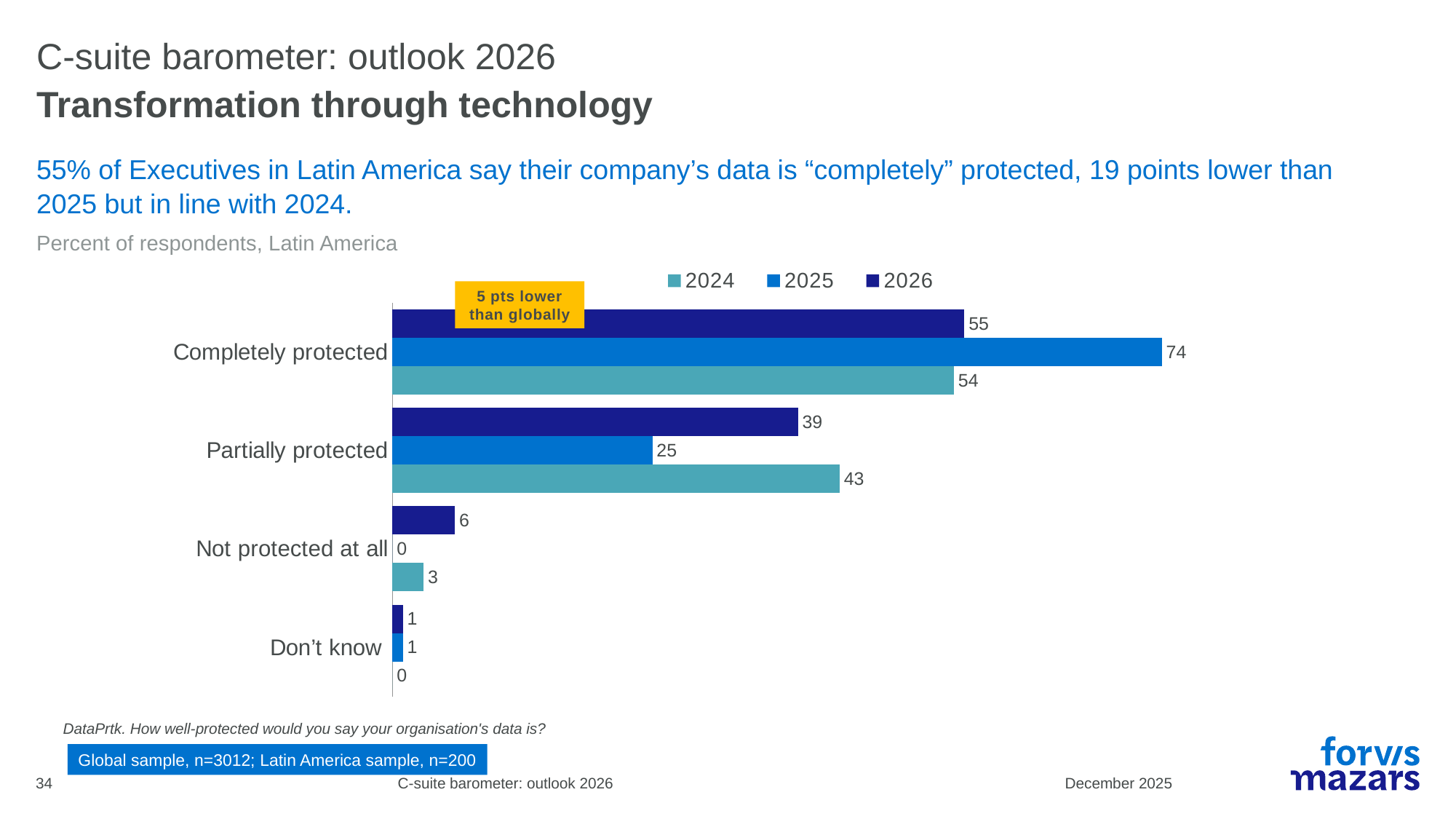
What is the 2024 value for Not protected at all? 3 Which category has the highest 2025 value? Completely protected What is the difference between the 2025 and 2026 values for Completely protected? 19 What is the 2026 value for Not protected at all? 6 What is the 2026 value for Completely protected? 55 What does the yellow callout box on the chart say? 5 pts lower than globally How many categories are shown on the chart? 4 Which category has the lowest 2024 value? Don't know How many series does the legend list? 3 What is the 2025 value for Partially protected? 25 Which is larger for Partially protected: the 2024 value or the 2026 value? 2024 What kind of chart is shown on the slide? Bar chart